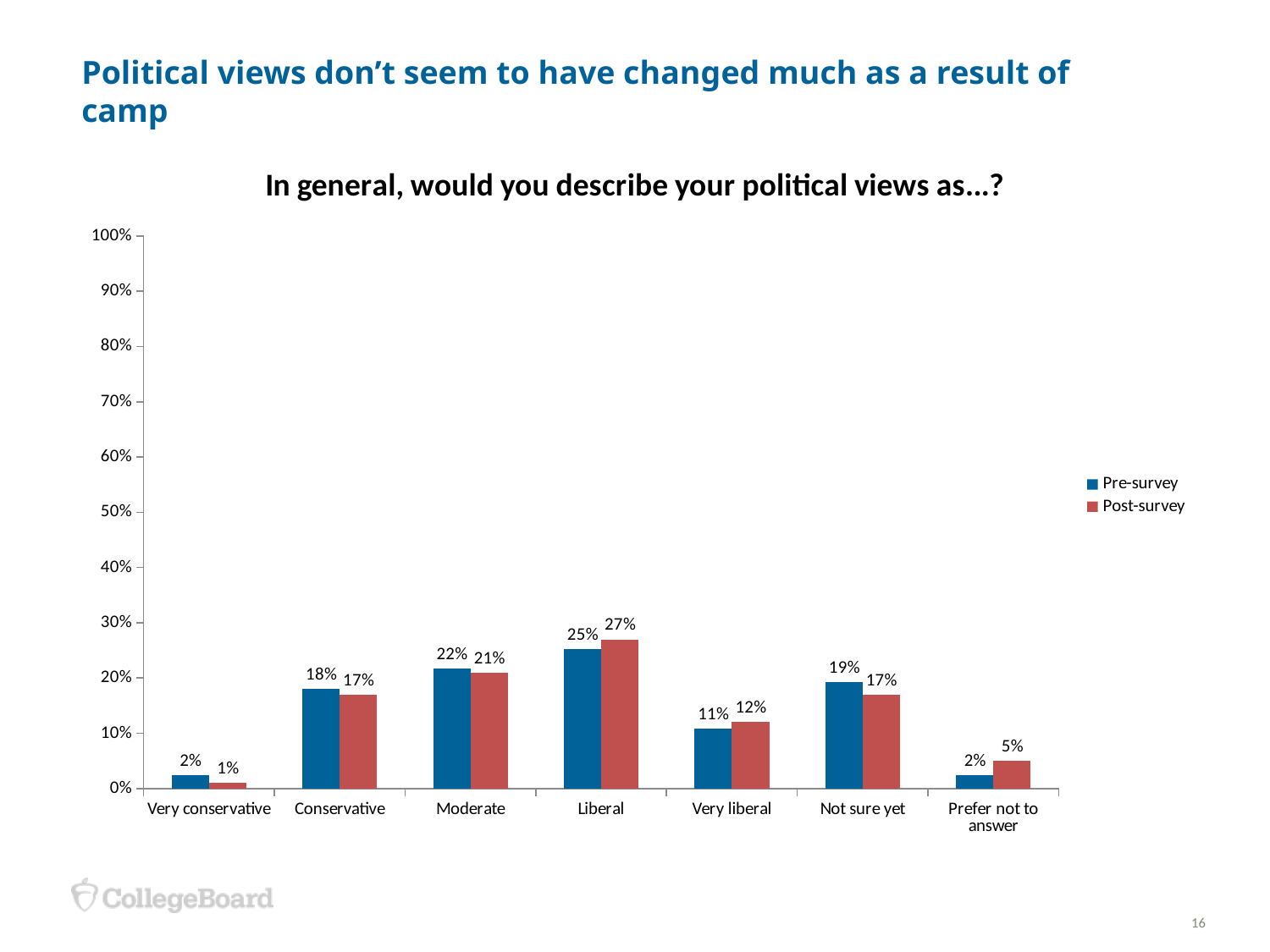
What is the Post-survey value for Not sure yet? 17% Which is larger for Moderate: the Pre-survey value or the Post-survey value? Pre-survey How many categories are shown on the x axis? 7 Which category has the lowest Post-survey value? Very conservative What is the difference between the Pre-survey and Post-survey values for Prefer not to answer? 3% Which category has the highest Post-survey value? Liberal What kind of chart is shown on the slide? Bar chart How many series does the legend list? 2 What is the Post-survey value for Prefer not to answer? 5% What is the title of the chart? In general, would you describe your political views as...? What is the Pre-survey value for Liberal? 25% What is the difference between the Post-survey and Pre-survey values for Liberal? 2%